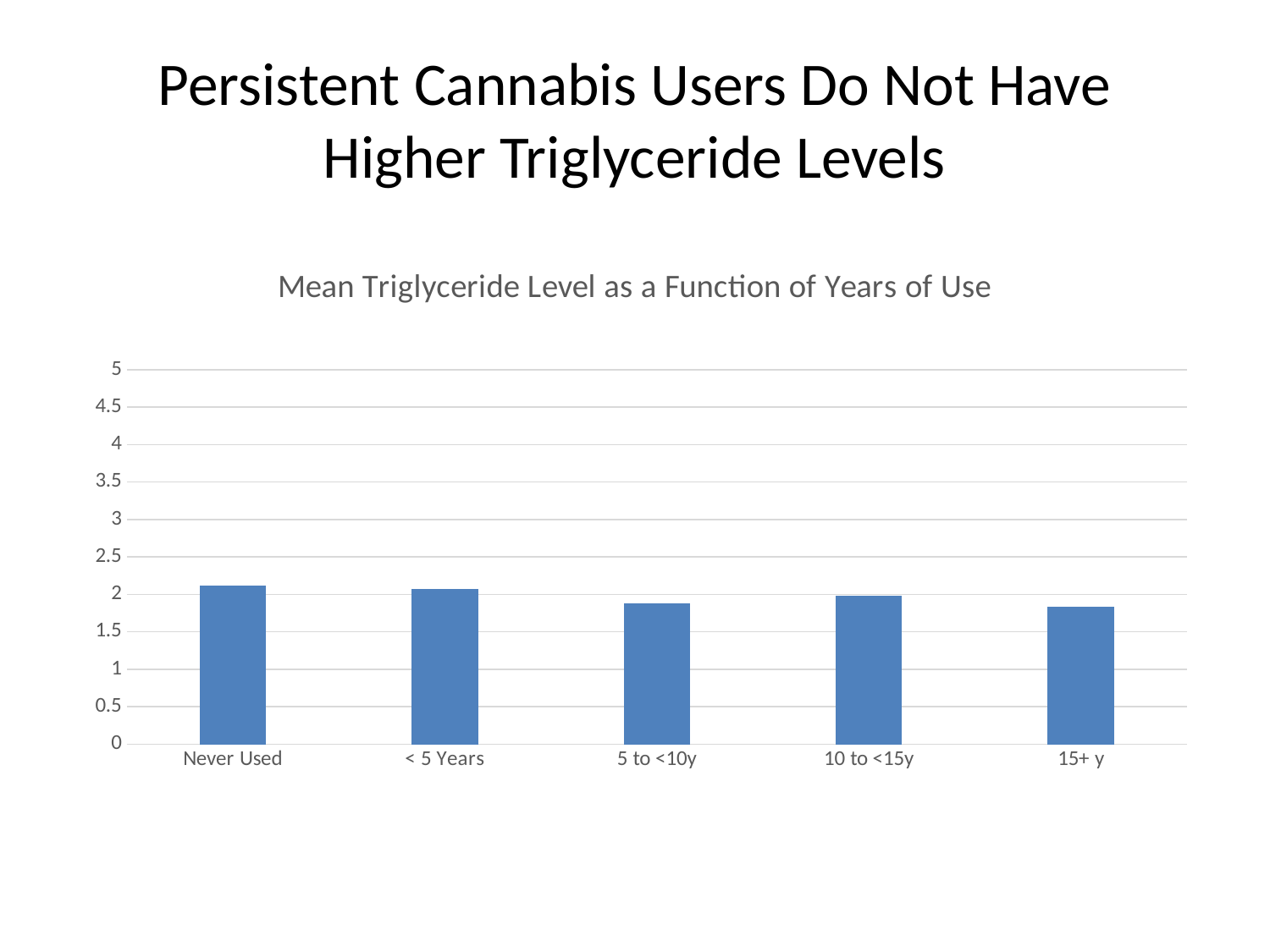
Overall, do the values rise or fall from Never Used to 15+ y? fall Is the value for Never Used greater or less than 2? greater What is the title of the chart? Mean Triglyceride Level as a Function of Years of Use Is the value for 10 to <15y greater or less than 2.5? less Is the value for 5 to <10y greater or less than 2? less What is the highest value shown on the y axis? 5 Which is larger, the value for < 5 Years or the value for 5 to <10y? < 5 Years How many categories of years of use are shown on the x axis? 5 Which is larger, the value for Never Used or the value for 15+ y? Never Used What type of chart is shown on the slide? Bar chart